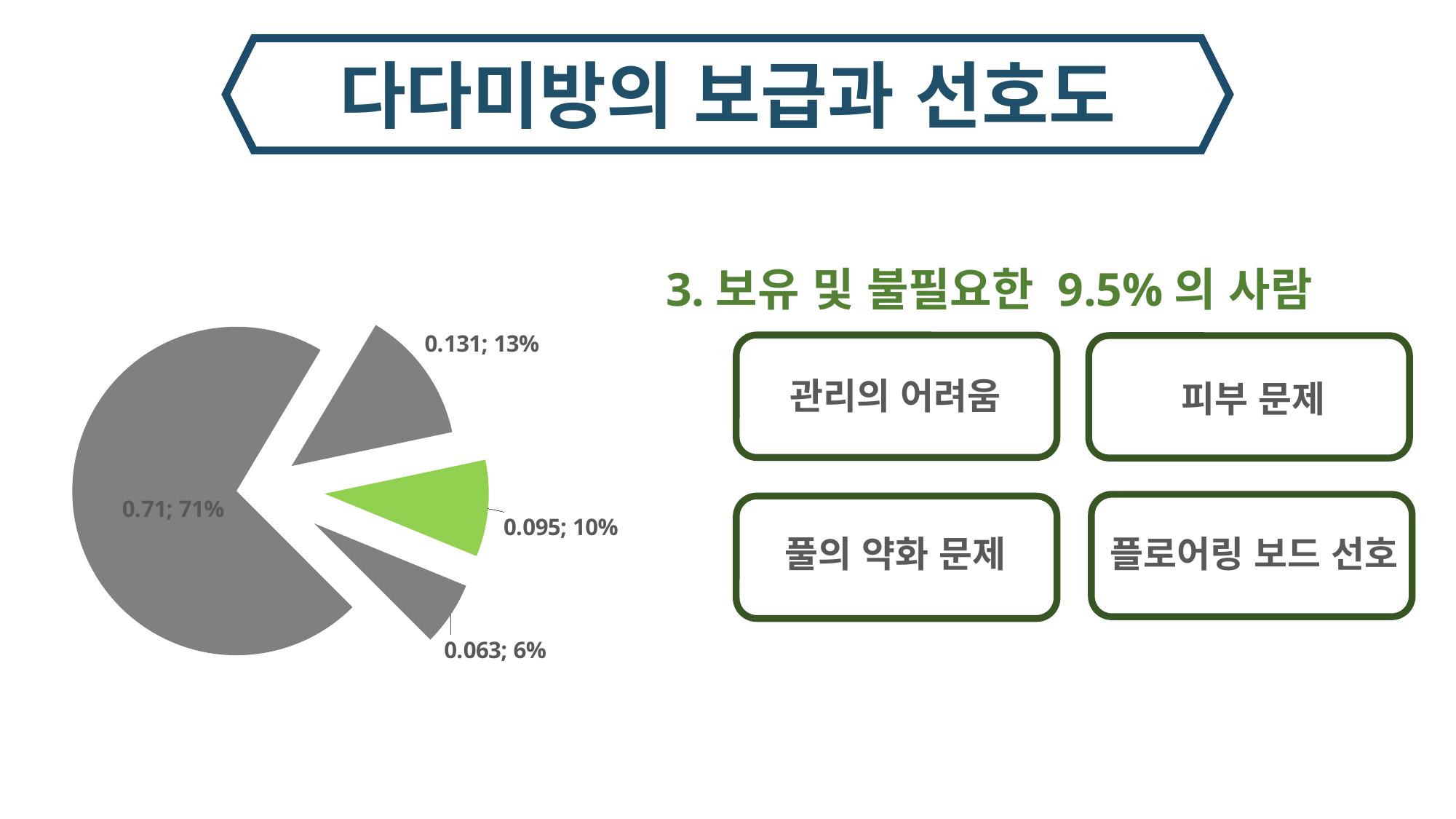
What is the difference in percentage points between the slice labeled 13% and the slice labeled 6%? 7 percentage points How many slices does the pie chart have? 4 Is the share of the largest slice of the pie chart greater or less than 50%? greater What is the data label on the green slice of the pie chart? 0.095; 10% What percentage share does the green slice of the pie chart represent? 10% Which is larger: the green slice or the slice labeled 0.131? The slice labeled 0.131 What colour is the highlighted slice of the pie chart that differs from the others? Green What percentage share does the largest grey slice of the pie chart represent? 71% What is the difference between the values 0.131 and 0.095 shown on the pie chart? 0.036 What is the data label on the smallest slice of the pie chart? 0.063; 6% What kind of chart is shown on the left of the slide? Pie chart What is the data label on the largest slice of the pie chart? 0.71; 71%